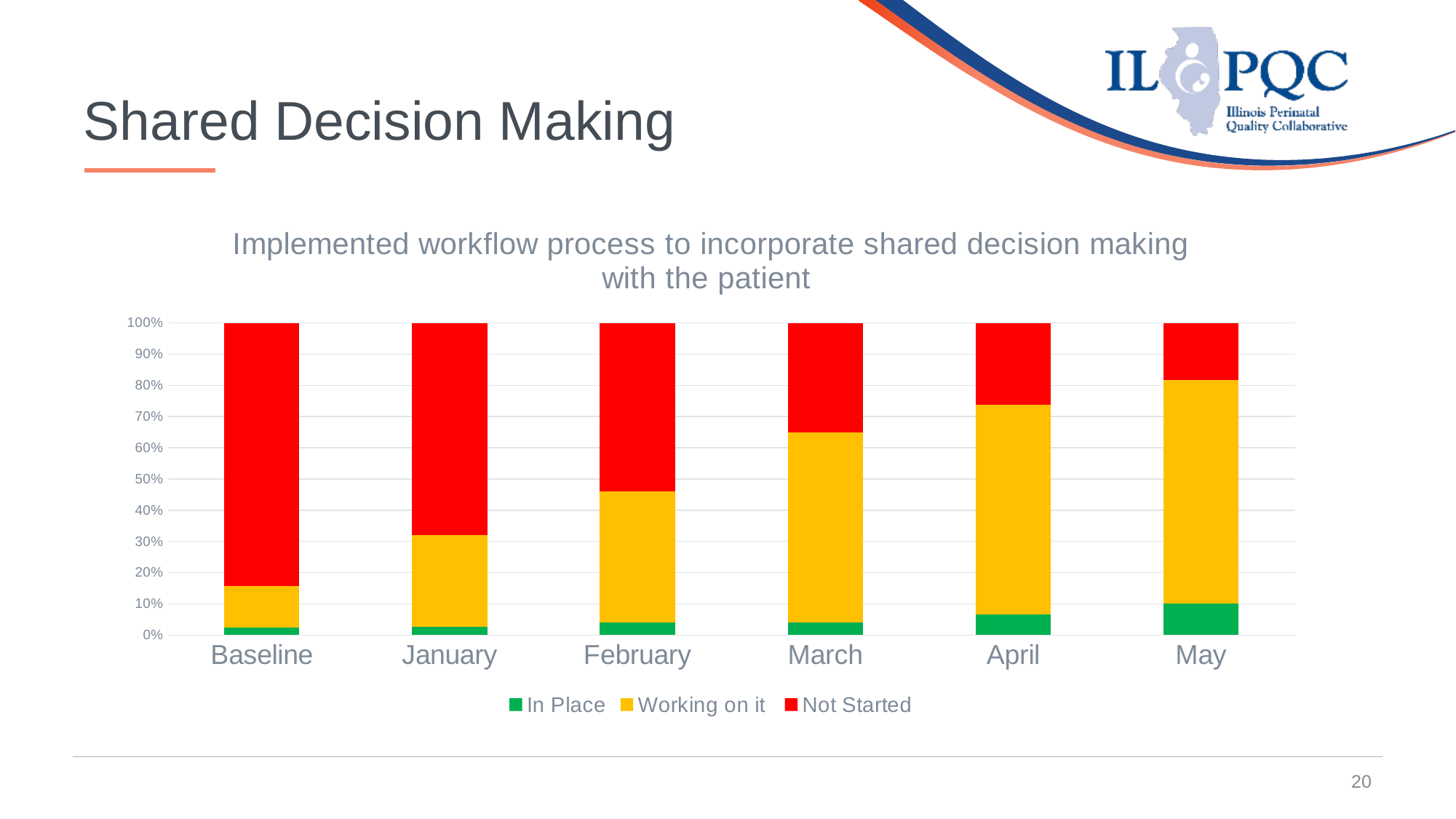
Is the 'Not Started' share for January greater or less than 60%? greater Is the 'In Place' share for May greater or less than 5%? greater Which category has the smallest 'Not Started' share? May Is the 'Not Started' share for May greater or less than 30%? less What kind of chart is shown on the slide? Stacked bar chart Does the 'In Place' share rise or fall from Baseline to May? rise Which is larger, the 'Working on it' share for March or for January? March How many series does the legend list? 3 How many categories are shown along the x axis? 6 Which category has the largest 'Not Started' share? Baseline Which category has the largest 'In Place' share? May